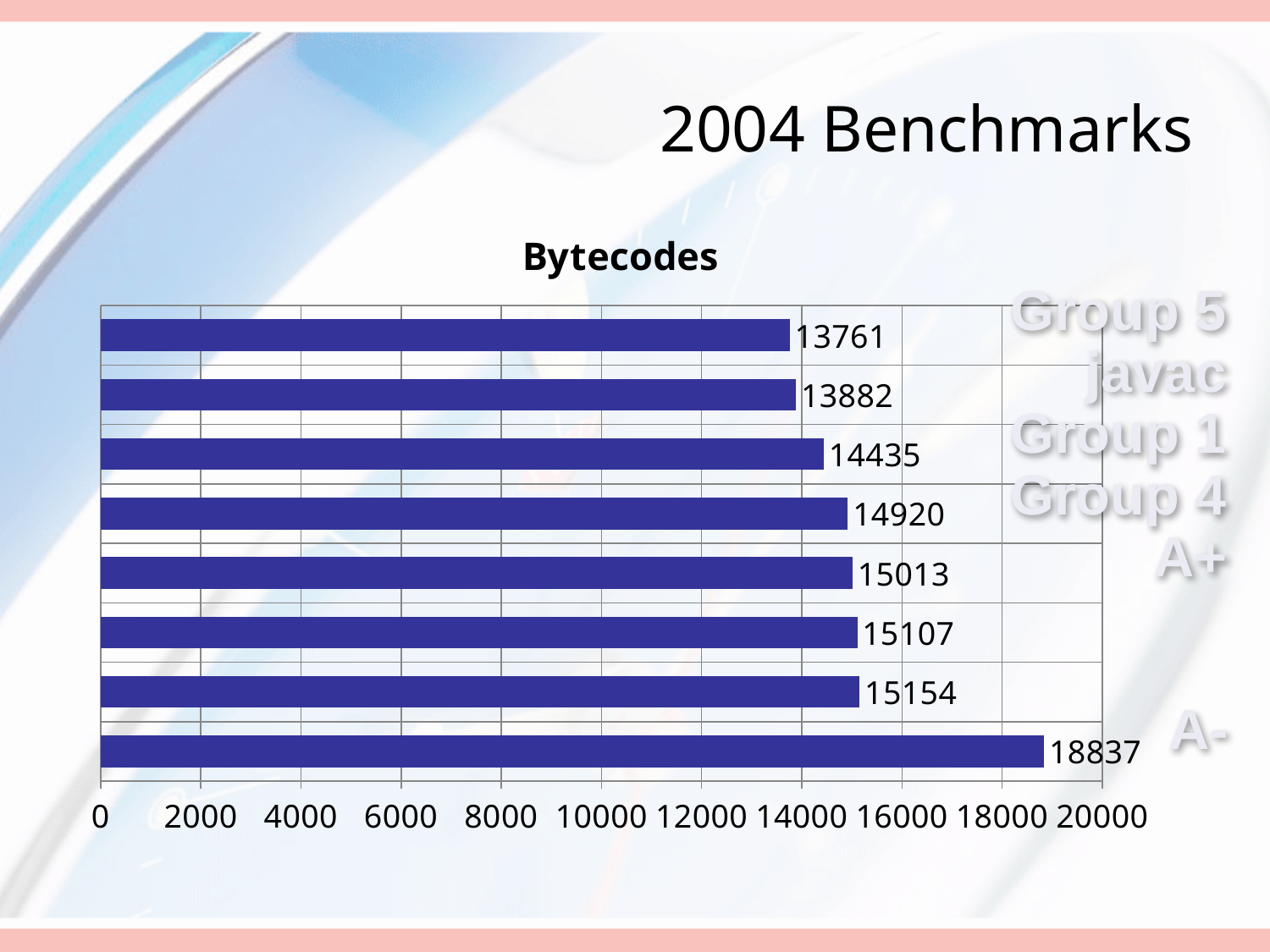
What is the smallest value shown in the Bytecodes chart? 13761 What is the largest value shown in the Bytecodes chart? 18837 What kind of chart is shown on the slide? bar chart Which is larger in the Bytecodes chart: the second bar from the top (13882) or the fourth bar from the top (14920)? 14920 What is the value of the top bar in the Bytecodes chart? 13761 What is the value of the bottom bar in the Bytecodes chart? 18837 What is the value of the third bar from the top in the Bytecodes chart? 14435 What is the difference between the largest and smallest values in the Bytecodes chart? 5076 Do the bar values in the Bytecodes chart increase or decrease going from the top bar to the bottom bar? increase What is the title of the chart? Bytecodes Is the value of the bottom bar in the Bytecodes chart greater or less than 18000? greater How many bars does the Bytecodes chart show? 8